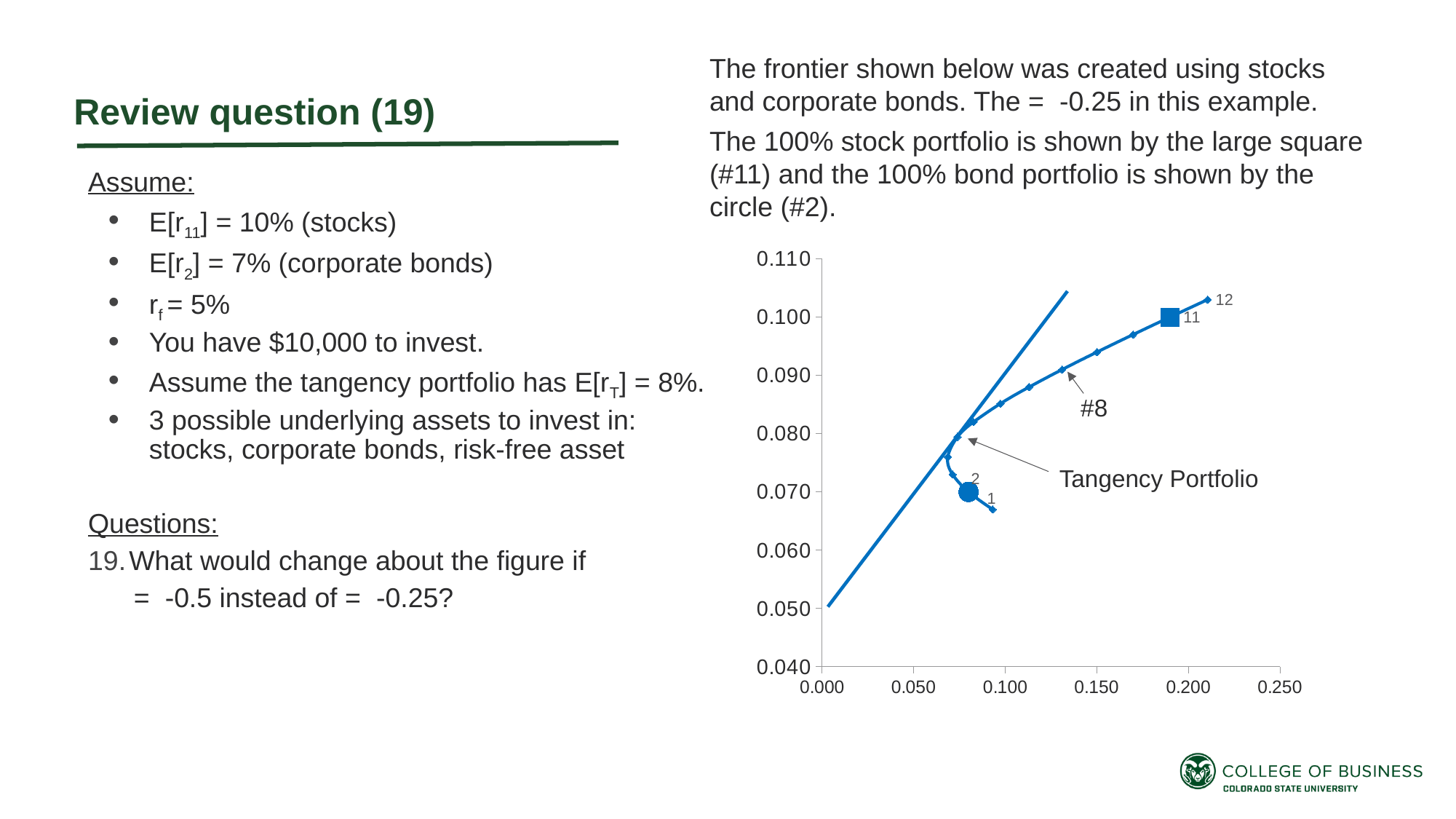
Is the y-axis value of point 1 greater or less than 0.070? less Is the x-axis value of the point labeled #8 greater or less than 0.100? greater What is the difference between the y-axis values of point 11 and point 2? 0.030 What kind of chart is shown on the slide? scatter chart Which labeled point on the frontier has the lowest y-axis value? 1 At what y-axis value does the straight line start on the vertical axis? 0.050 Is the y-axis value of point 12 greater or less than 0.100? greater What is the y-axis value of the large square marker labeled 11? 0.100 What is the y-axis value of the circle marker labeled 2? 0.070 According to the slide, what portfolio does the large square marker represent? 100% stock portfolio Which has the higher y-axis value, point 12 or point 11? point 12